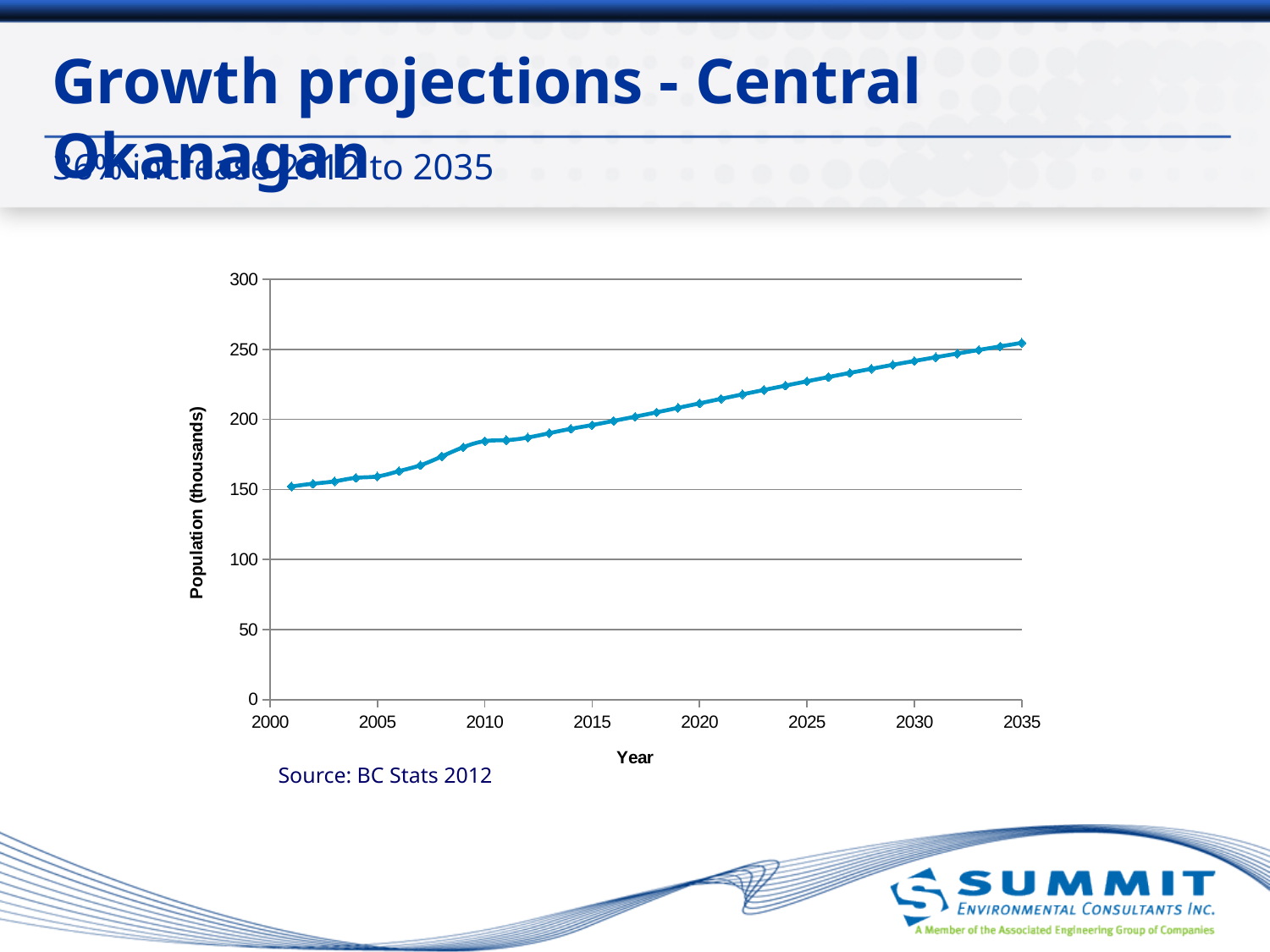
Does the population rise or fall from 2000 to 2035 along the x axis? rise What is the label of the y axis? Population (thousands) What source is cited below the chart? Source: BC Stats 2012 Is the population value for 2010 greater or less than 200? less What kind of chart is shown on the slide? line chart Is the population value for 2005 greater or less than 200? less Is the population value for 2010 greater or less than 150? greater Which year has the lowest population value on the chart? 2001 Which year has the larger population value, 2010 or 2025? 2025 Which year has the highest population value on the chart? 2035